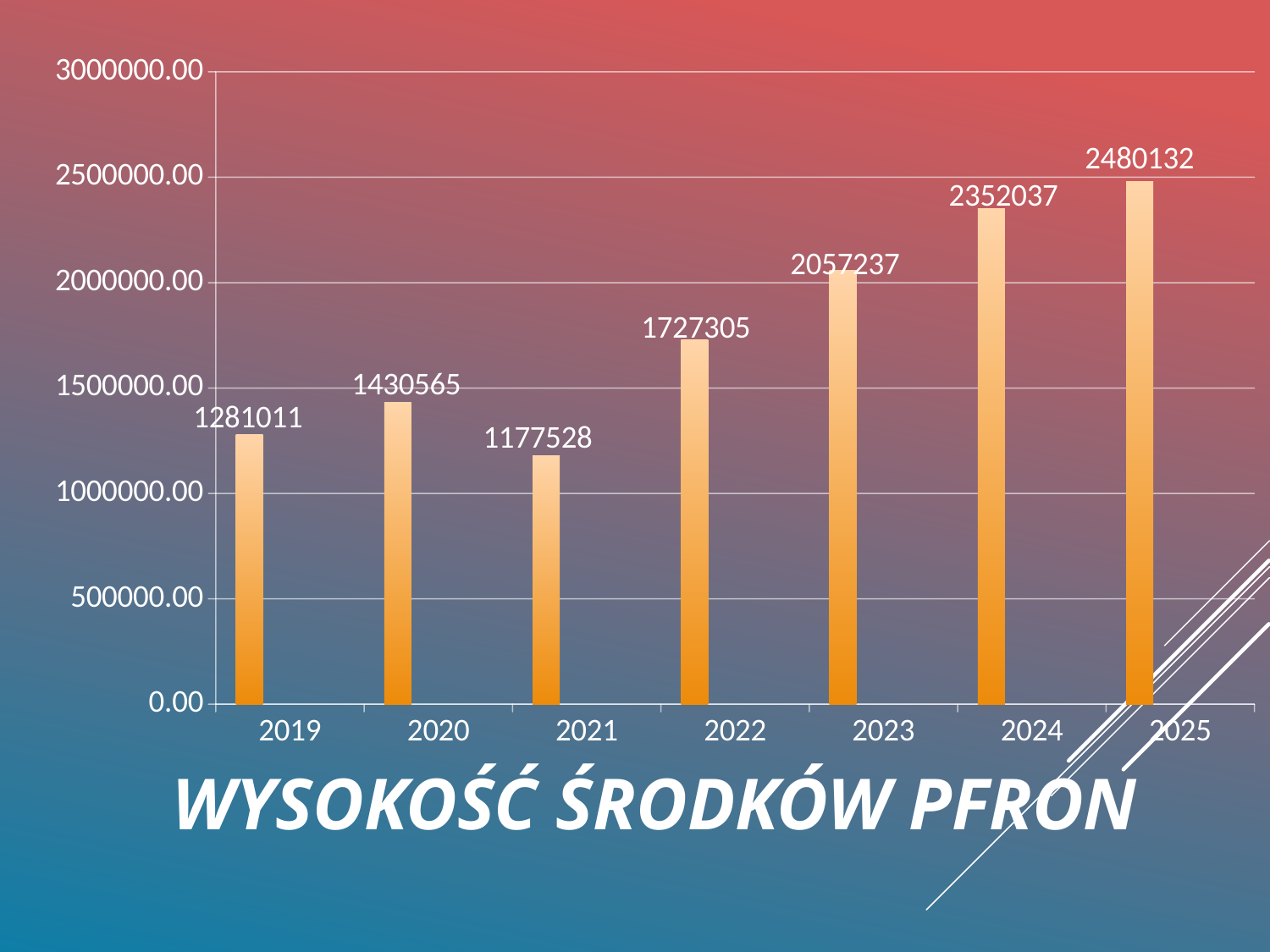
Is the value for 2023 greater or less than 2000000.00? greater Which is larger, the value for 2020 or the value for 2021? 2020 What is the value for 2019? 1281011 What is the value for 2023? 2057237 What is the value for 2025? 2480132 What is the difference between the values for 2025 and 2024? 128095 What is the difference between the values for 2022 and 2021? 549777 Do the values rise or fall from 2022 to 2025? rise Which year has the highest value? 2025 How many years are shown on the x axis? 7 What kind of chart is shown on the slide? bar chart Which year has the lowest value? 2021